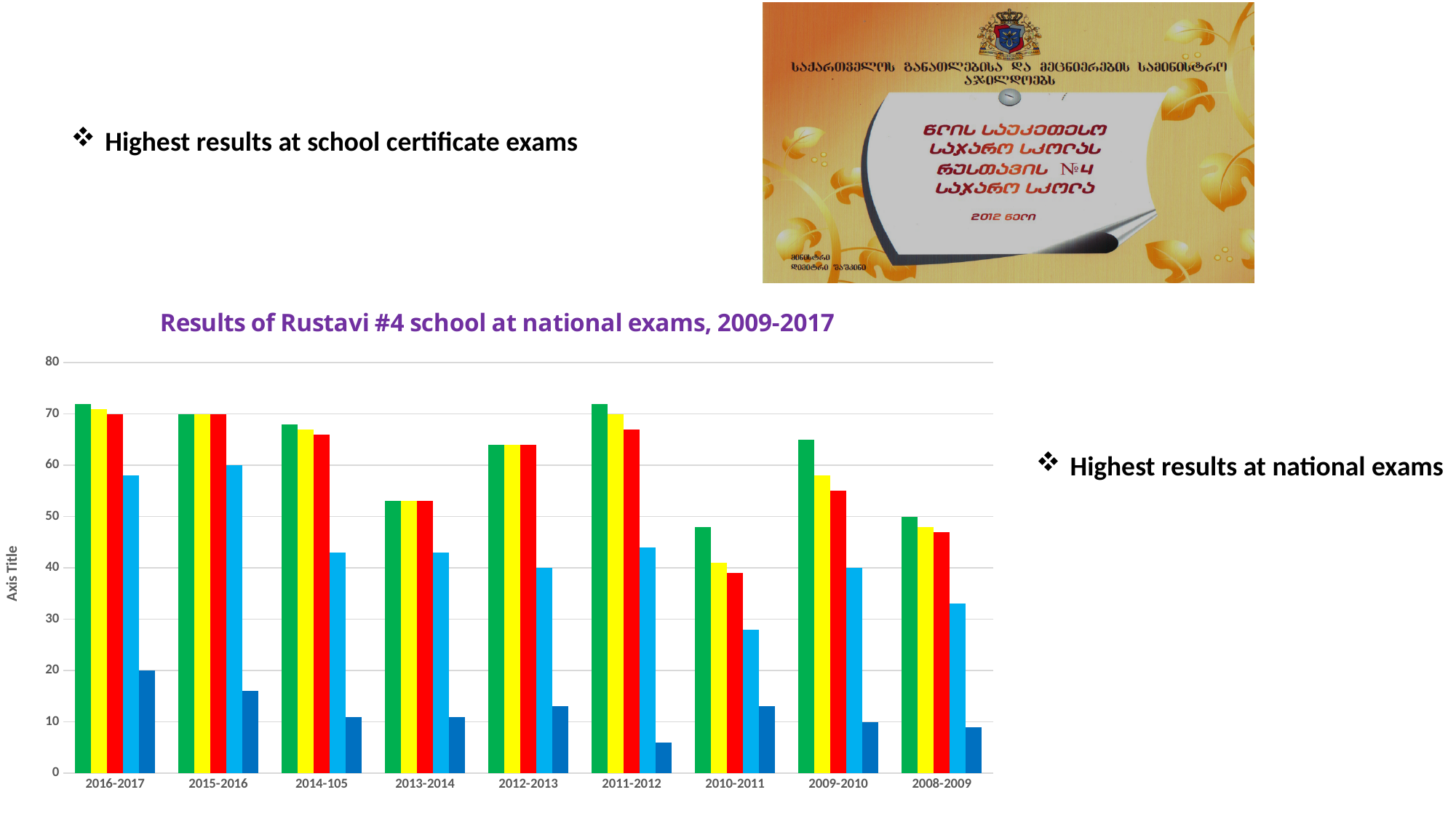
Is the value of the light blue bar for 2016-2017 greater or less than 60? less What is the label shown on the vertical axis of the chart? Axis Title Is the value of the light blue bar for 2008-2009 greater or less than 30? greater What kind of chart is shown on the slide? bar chart Which is larger, the green bar for 2016-2017 or the green bar for 2013-2014? 2016-2017 Is the value of the green bar for 2010-2011 greater or less than 50? less Which category has the lowest dark blue bar? 2011-2012 Which category has the lowest light blue bar? 2010-2011 What is the title of the chart? Results of Rustavi #4 school at national exams, 2009-2017 How many academic-year categories are shown on the x axis of the chart? 9